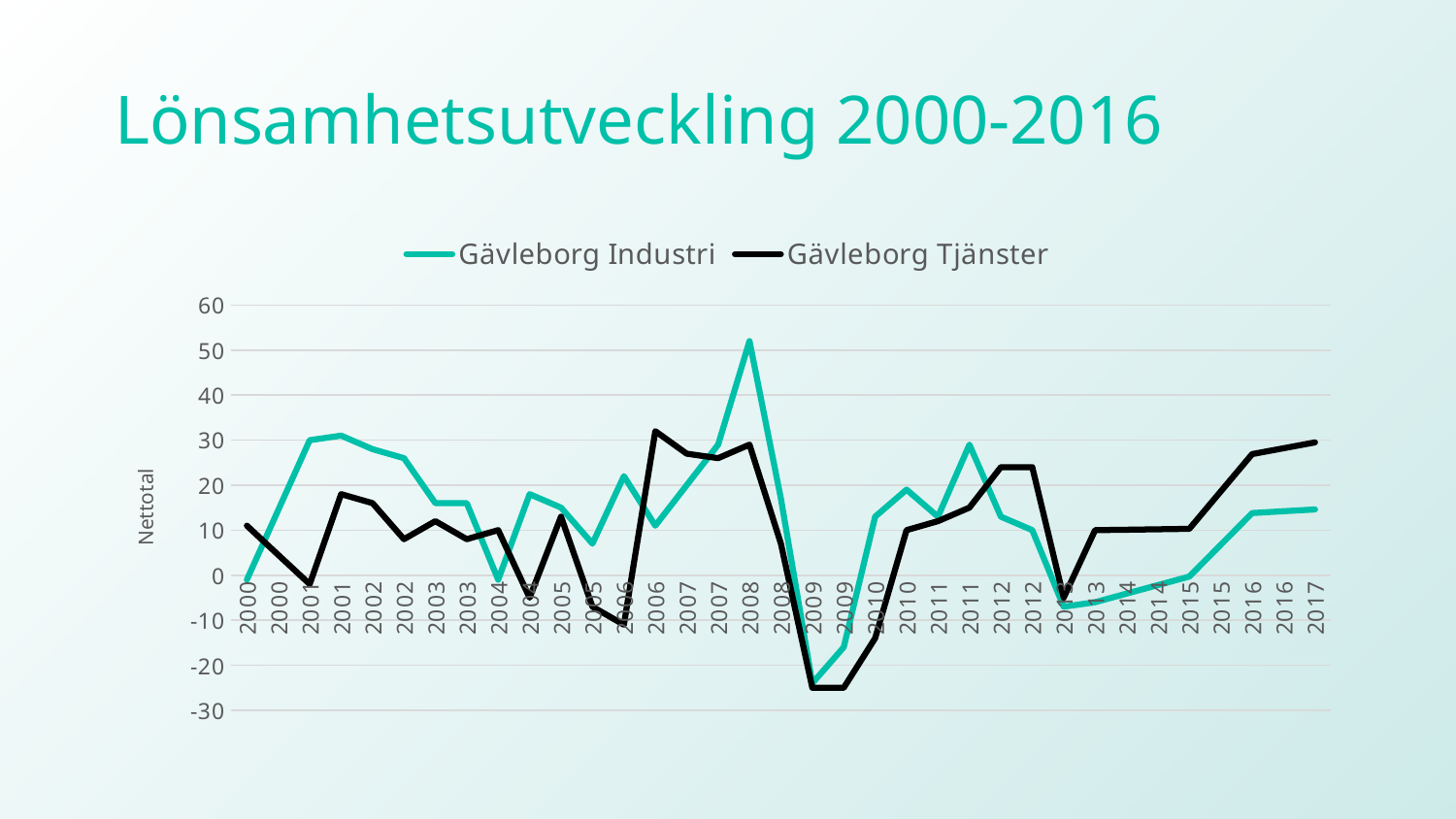
What is the label on the vertical axis? Nettotal What is the title of the slide's chart? Lönsamhetsutveckling 2000-2016 How many series does the legend list? 2 In 2017, which series has the higher value, Gävleborg Industri or Gävleborg Tjänster? Gävleborg Tjänster Is the value for Gävleborg Industri in 2017 greater or less than 20? less Is the value for Gävleborg Tjänster in 2017 greater or less than 20? greater At the 2008 peak, which series is higher, Gävleborg Industri or Gävleborg Tjänster? Gävleborg Industri Which series reaches the highest value anywhere on the chart? Gävleborg Industri What kind of chart is shown on the slide? line chart Does the Gävleborg Tjänster line rise or fall from 2015 to 2017? rise Is the peak value for Gävleborg Industri in 2008 greater or less than 40? greater